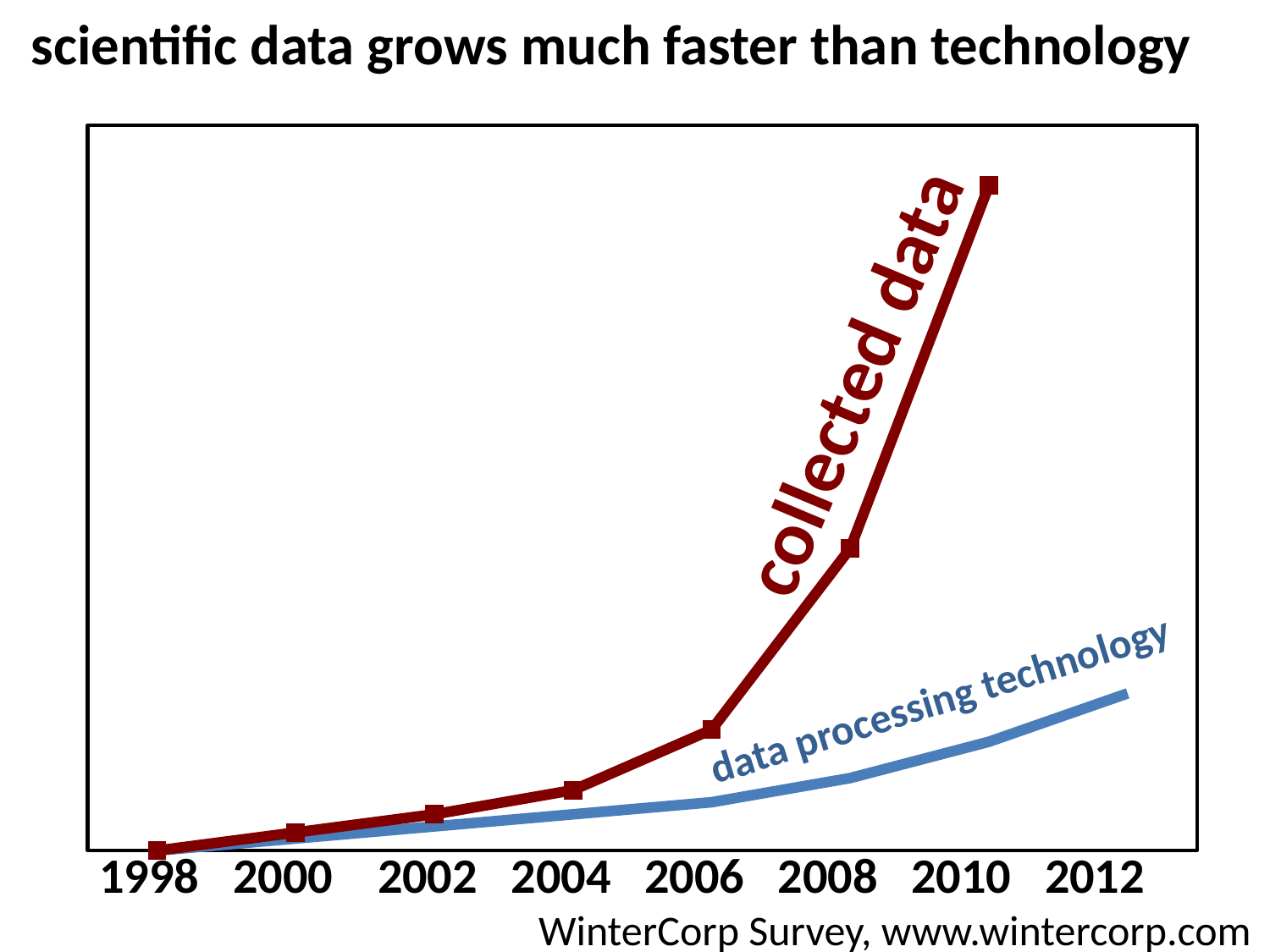
How many series are plotted on the chart? 2 What are the names of the two series plotted on the chart? collected data; data processing technology In 2010, which series has the higher value: collected data or data processing technology? collected data What kind of chart is shown on the slide? line chart In which year is the collected data series at its lowest value? 1998 Does the collected data line rise or fall from 1998 to 2010? rise Does the data processing technology line rise or fall along the x axis? rise How many years are labelled on the x axis? 8 How many marked data points does the collected data line have? 7 In which year does the collected data series reach its highest value? 2010 What is the title of the slide? scientific data grows much faster than technology Which series grows faster over the period shown: collected data or data processing technology? collected data